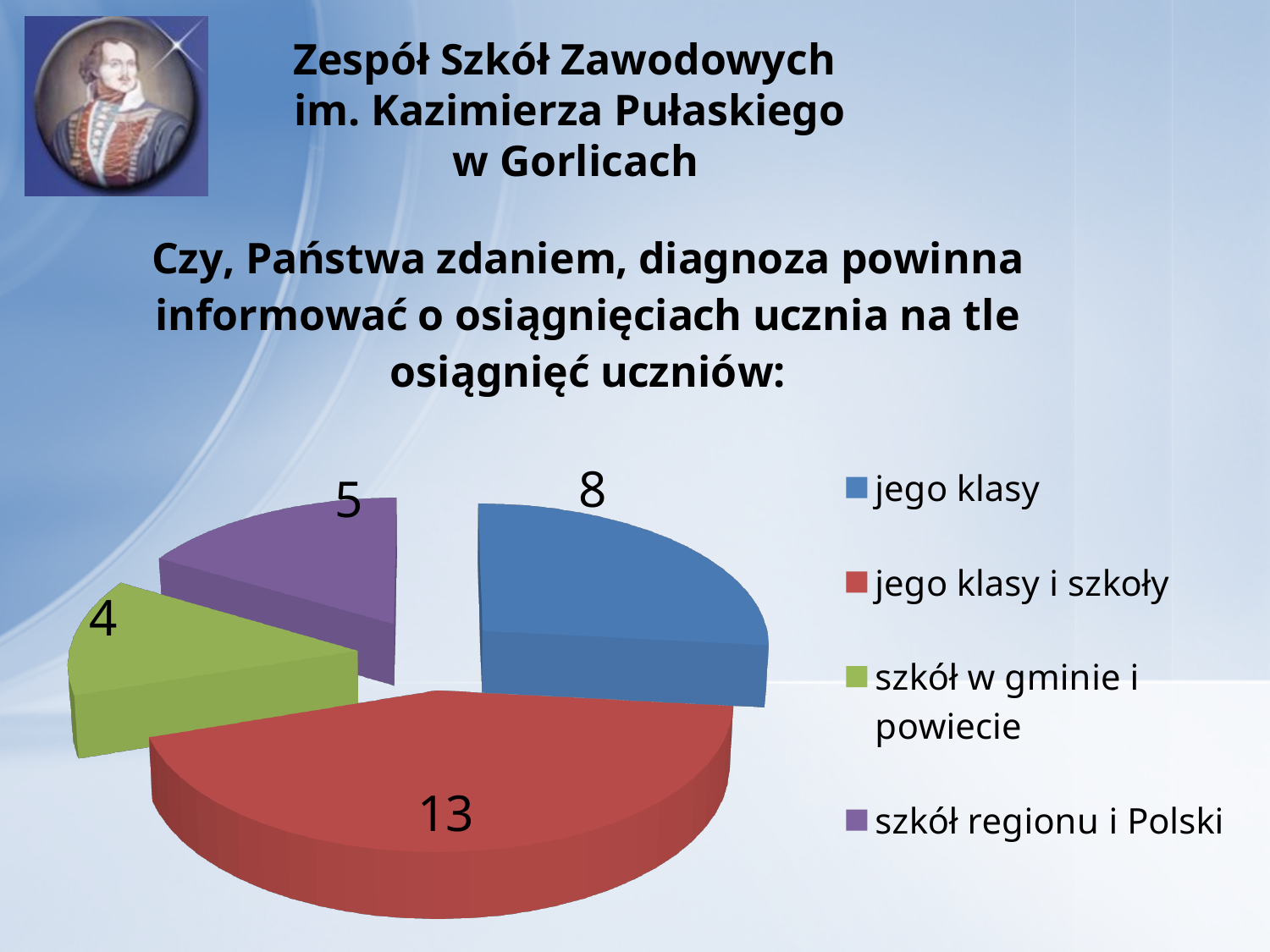
What is the total of all the slices in the pie chart? 30 What kind of chart is shown on the slide? pie chart What is the value for "szkół w gminie i powiecie"? 4 What is the value for "jego klasy i szkoły"? 13 Which colour represents "jego klasy i szkoły" in the pie chart? red How many categories does the pie chart have? 4 What is the difference between the values for "jego klasy i szkoły" and "jego klasy"? 5 Which category has the highest value? jego klasy i szkoły Which category has the lowest value? szkół w gminie i powiecie What is the value for "szkół regionu i Polski"? 5 What is the value for "jego klasy"? 8 Which is larger, the value for "szkół regionu i Polski" or the value for "szkół w gminie i powiecie"? szkół regionu i Polski